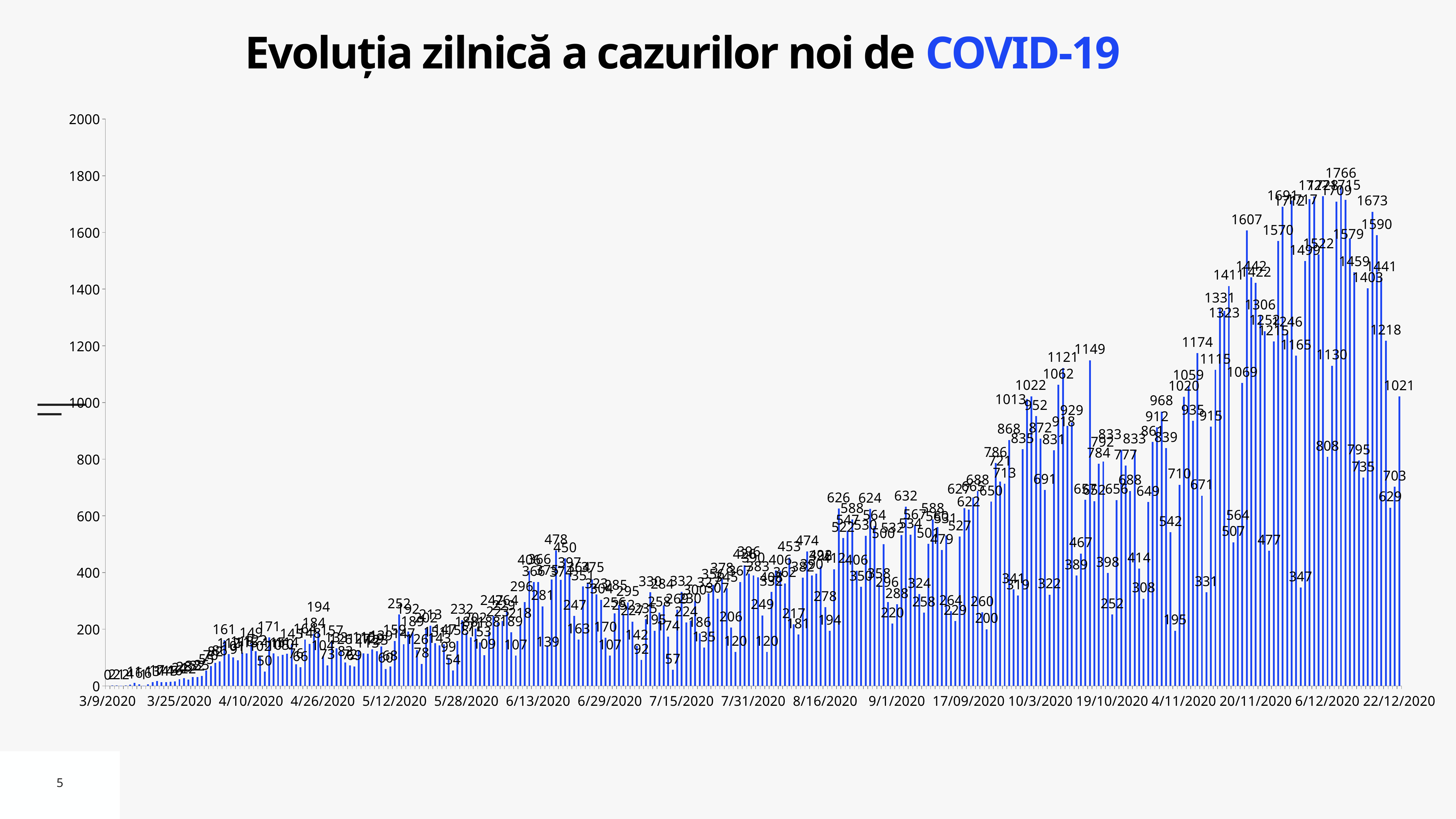
What is the maximum value shown on the vertical axis? 2000 How much higher is the peak value of 1766 than the final bar's value of 1021? 745 Overall, do the daily values rise or fall from March 2020 to December 2020? rise Is the value for 4/26/2020 greater or less than 400? less Is the value for 3/9/2020 greater or less than 200? less What is the title of the chart? Evoluția zilnică a cazurilor noi de COVID-19 What is the lowest value labeled on the chart, at the very start of the series? 0 What kind of chart is shown on the slide? bar chart Is the value for 22/12/2020 greater or less than 1000? greater What is the value of the last bar, at 22/12/2020? 1021 Which is larger, the peak value 1766 or the value 1673 labeled shortly after it? 1766 What is the highest daily value labeled on the chart? 1766